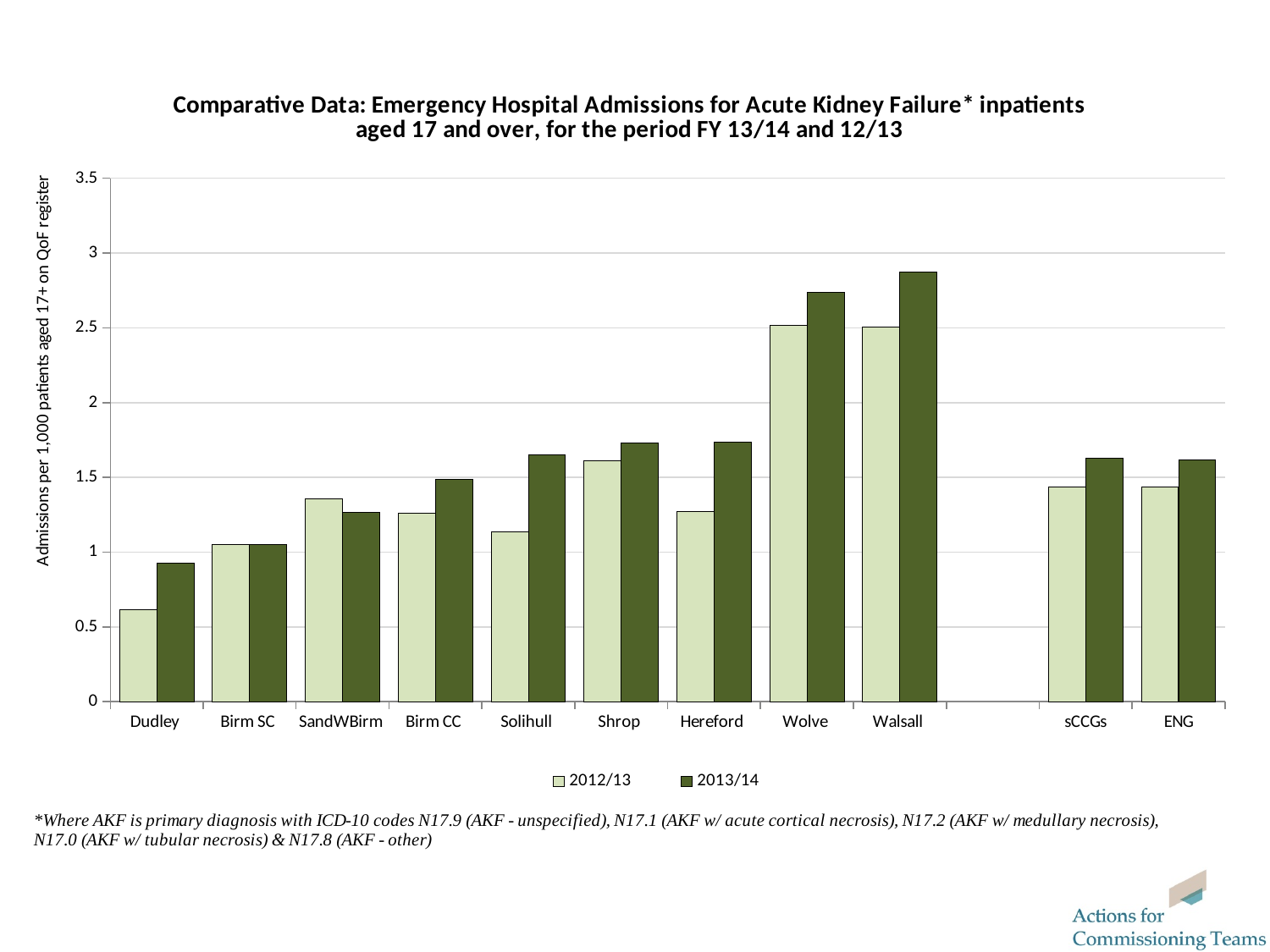
Is the 2013/14 value for Wolve greater or less than 2.5? greater Which category has the lowest value for 2013/14? Dudley For SandWBirm, which series has the larger value, 2012/13 or 2013/14? 2012/13 What kind of chart is shown on the slide? bar chart Which category has the lowest value for 2012/13? Dudley Is the 2012/13 value for Dudley greater or less than 1? less What does the y axis of the chart measure? Admissions per 1,000 patients aged 17+ on QoF register Is the 2013/14 value for Solihull greater or less than 1.5? greater How many series does the legend list? 2 Which category has the highest value for 2013/14? Walsall How many categories are shown on the x axis? 11